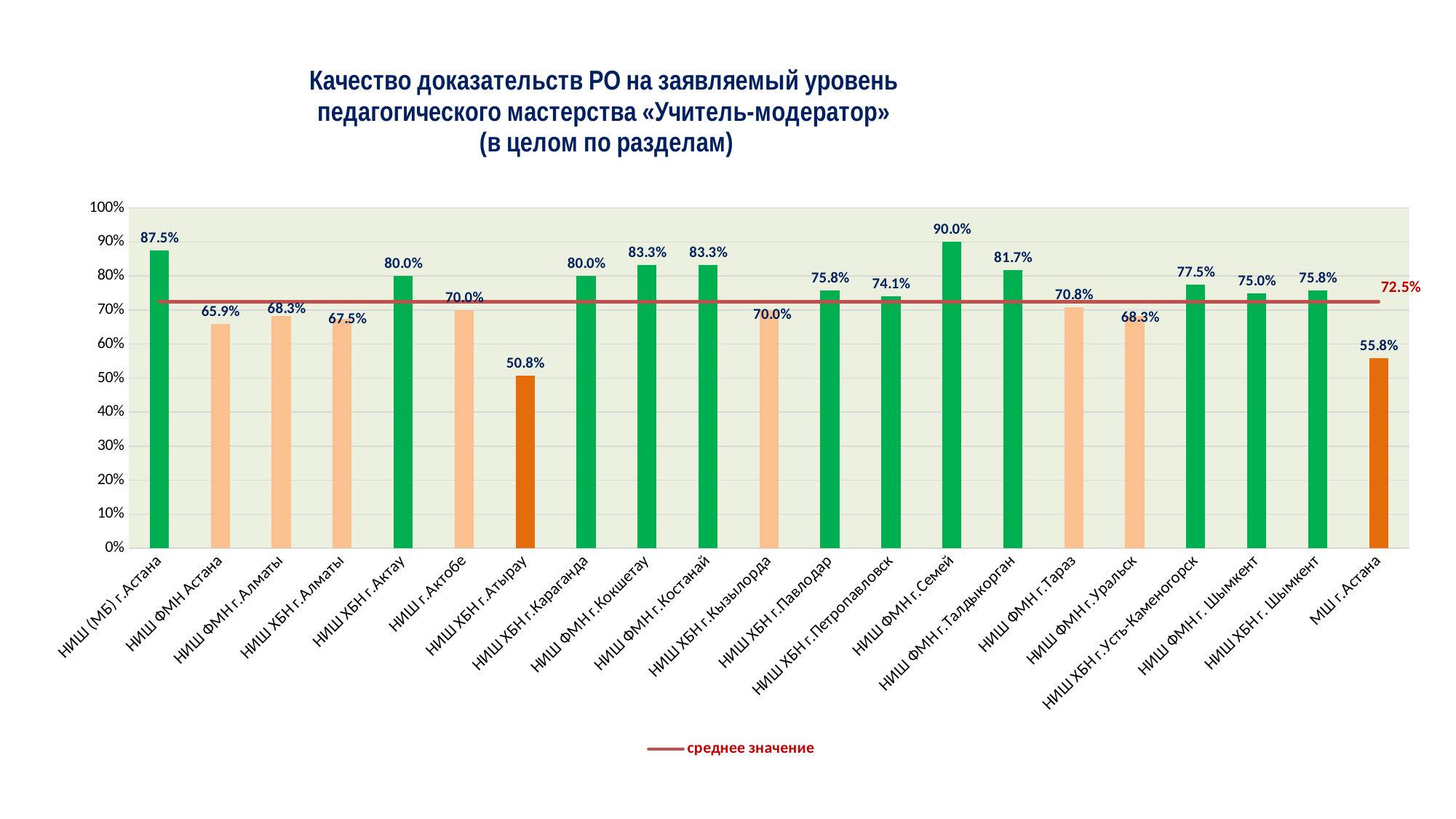
What is the value for НИШ ФМН г.Семей? 90.0% How many categories are shown on the x axis? 21 Which is larger, the value for НИШ ХБН г.Павлодар or НИШ ХБН г.Петропавловск? НИШ ХБН г.Павлодар What is the value for НИШ ХБН г.Атырау? 50.8% What is the value for МШ г.Астана? 55.8% What kind of chart is this? bar chart What is the value for НИШ ФМН г.Талдыкорган? 81.7% Which category has the highest value? НИШ ФМН г.Семей What value does the red horizontal line (среднее значение) mark? 72.5% Which category has the lowest value? НИШ ХБН г.Атырау What is the value for НИШ ХБН г.Усть-Каменогорск? 77.5% What is the difference between the values for НИШ (МБ) г.Астана and НИШ ФМН Астана? 21.6%